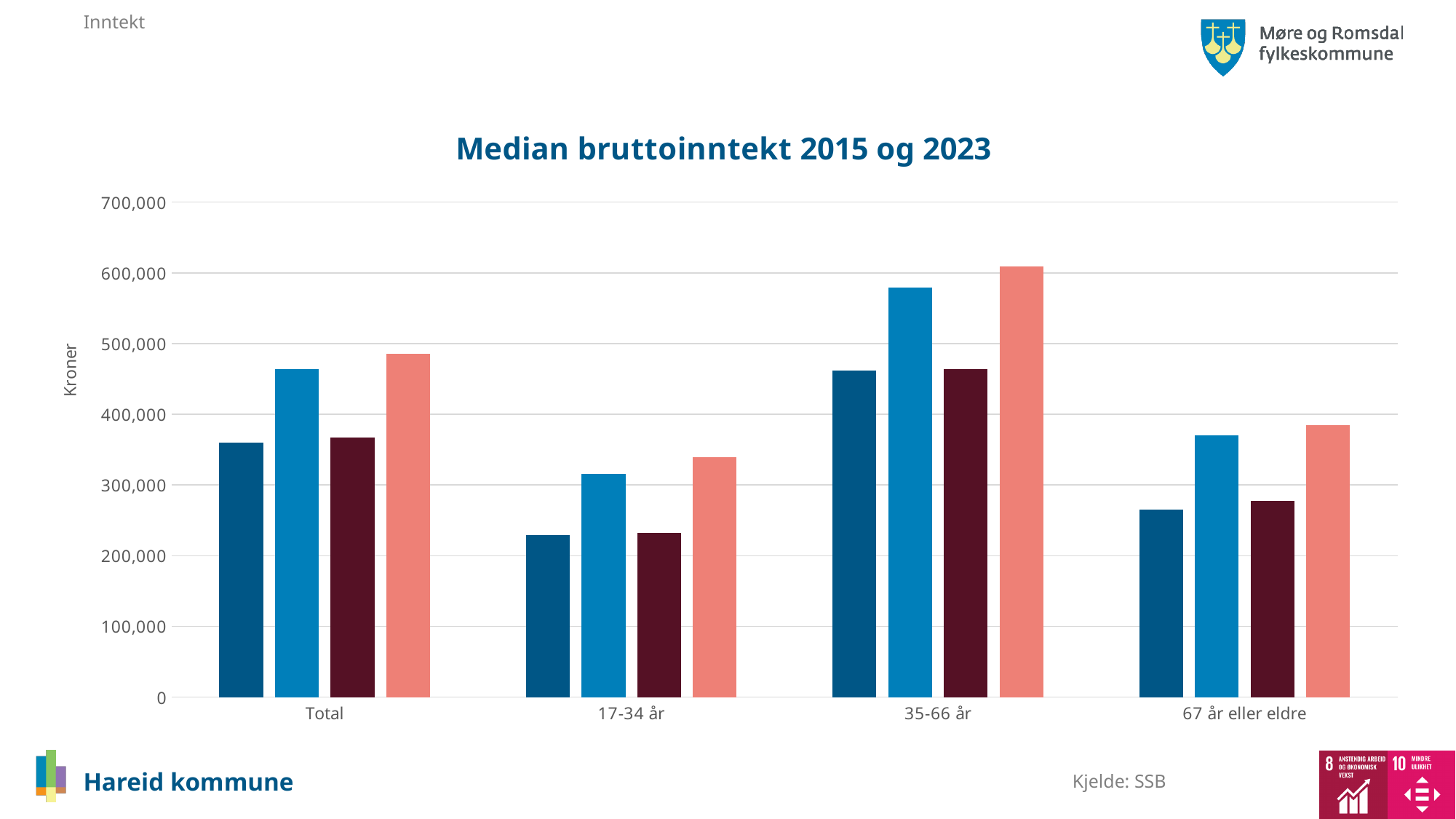
Is the value of the salmon-coloured bar for 35-66 år greater or less than 500,000? greater For the Total category, which is larger: the dark blue bar or the salmon-coloured bar? the salmon-coloured bar What is the label on the vertical axis of the chart? Kroner What kind of chart is shown on the slide? bar chart Which category has the shortest bars in the chart? 17-34 år Is the value of the dark blue bar for Total greater or less than 300,000? greater What is the title of the chart? Median bruttoinntekt 2015 og 2023 Which category has the tallest bars in the chart? 35-66 år Is the value of the dark blue bar for 67 år eller eldre greater or less than 300,000? less How many age categories are shown along the x axis? 4